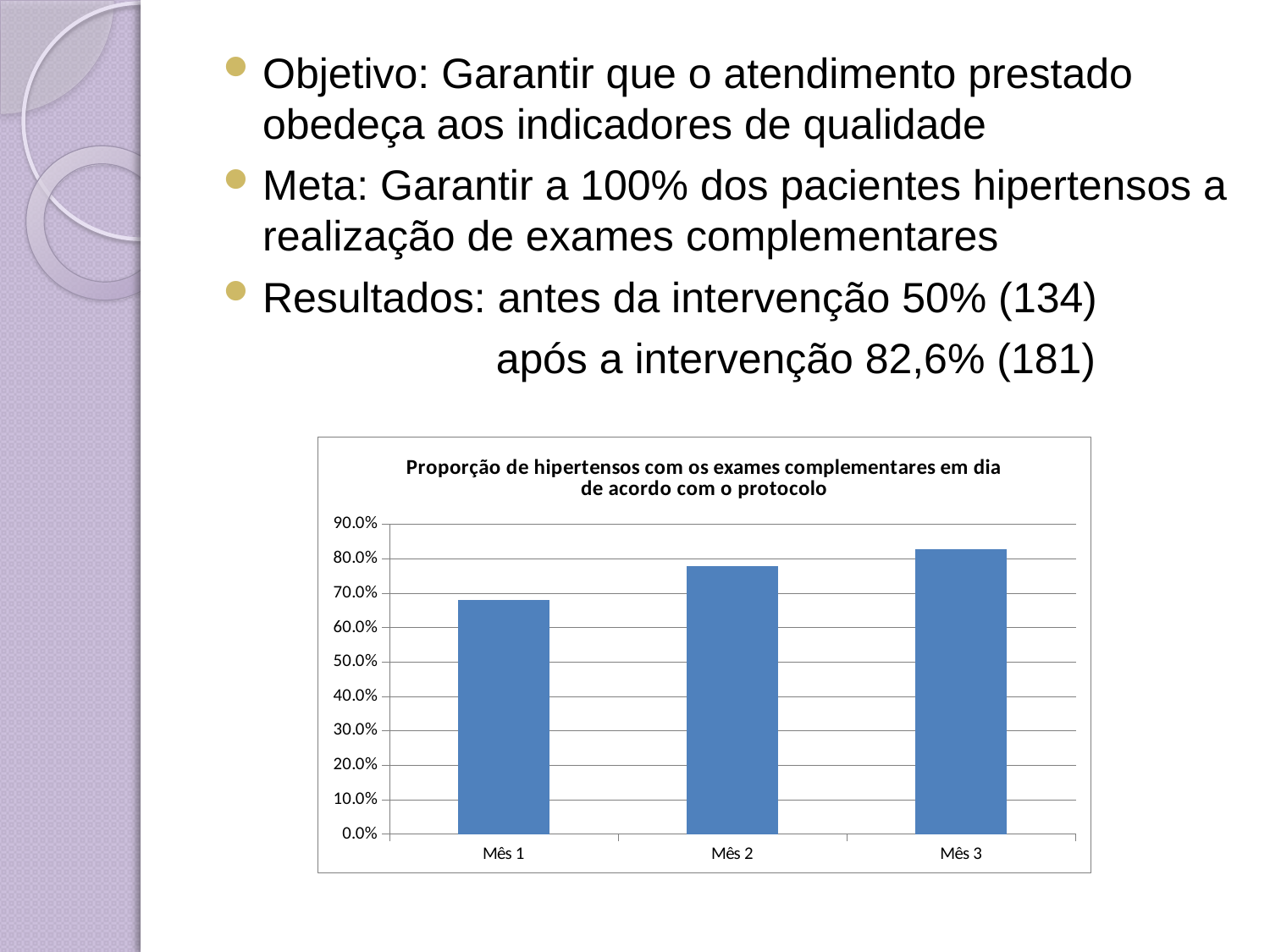
Is the value for Mês 2 greater or less than 70.0%? greater Is the value for Mês 1 greater or less than 60.0%? greater Which month has the lowest value in the chart? Mês 1 What kind of chart is shown on the slide? bar chart Which is larger, the value for Mês 2 or the value for Mês 1? Mês 2 What is the title of the chart? Proporção de hipertensos com os exames complementares em dia de acordo com o protocolo How many categories are plotted on the x axis of the chart? 3 Is the value for Mês 3 greater or less than 80.0%? greater Which month has the highest value in the chart? Mês 3 Do the values rise or fall from Mês 1 to Mês 3? rise